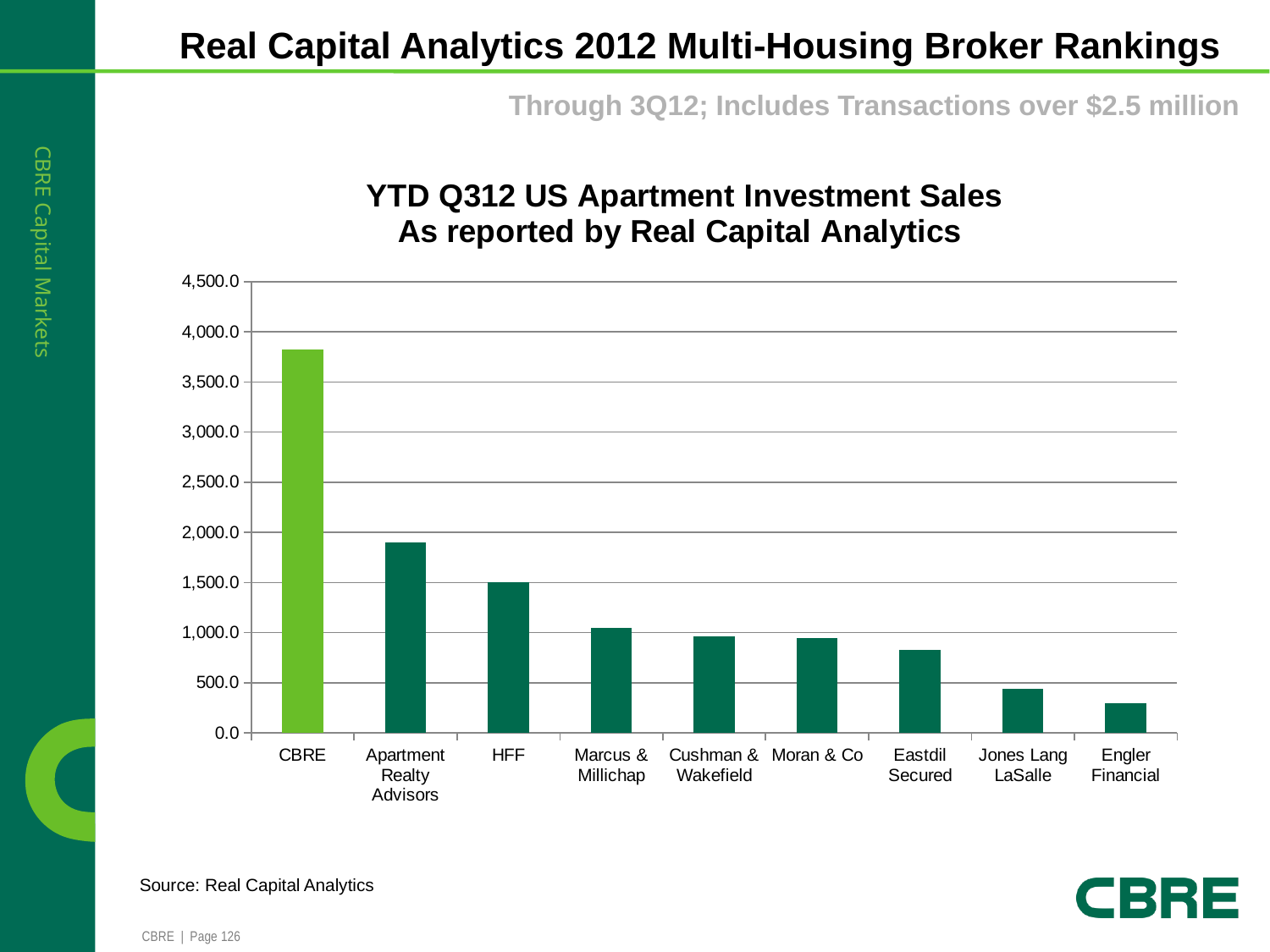
How many brokers are shown on the x axis of the chart? 9 What kind of chart is shown on the slide? bar chart Is the value for Jones Lang LaSalle greater or less than 500.0? less Which broker has the lowest YTD Q312 US apartment investment sales? Engler Financial What is the title of the chart? YTD Q312 US Apartment Investment Sales As reported by Real Capital Analytics Is the value for Eastdil Secured greater or less than 1,000.0? less Is the value for Apartment Realty Advisors greater or less than 2,000.0? less Which is larger, the value for HFF or the value for Moran & Co? HFF Which broker has the highest YTD Q312 US apartment investment sales? CBRE Do the bar values rise or fall moving from left to right along the x axis? fall